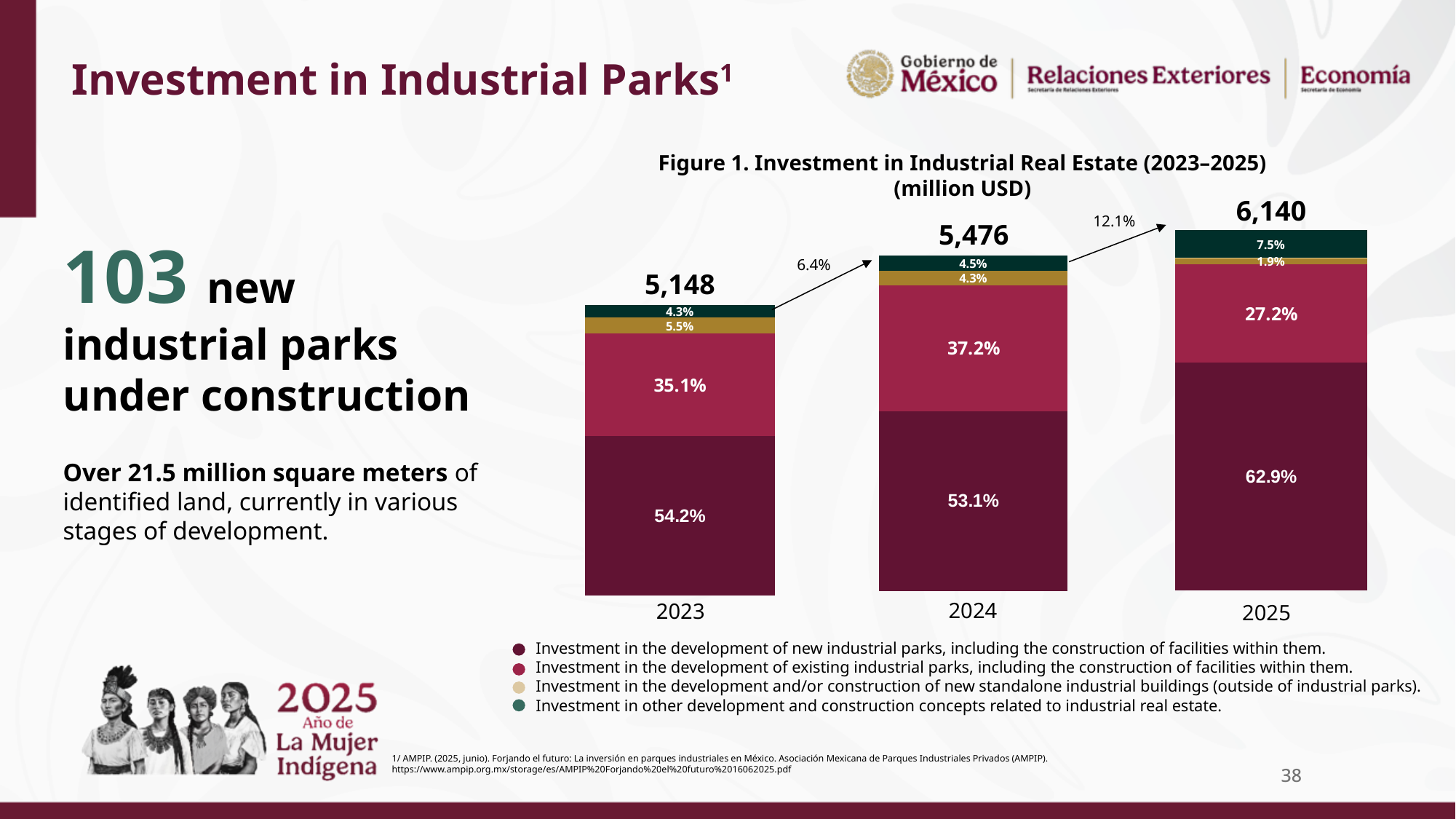
Which year has the lowest total investment in industrial real estate? 2023 What is the total investment in industrial real estate shown for 2024? 5,476 What share of the 2023 bar is investment in the development of new industrial parks? 54.2% Which year has the highest total investment in industrial real estate? 2025 What is the total investment in industrial real estate shown for 2025? 6,140 What growth percentage is shown on the arrow between the 2024 and 2025 bars? 12.1% How many series does the legend list? 4 How many years are shown on the x axis of the chart? 3 What share of the 2025 bar is investment in the development of existing industrial parks? 27.2% What is the difference between the total investment in 2025 and in 2023? 992 What percentage of the 2024 bar is investment in other development and construction concepts related to industrial real estate? 4.5% What kind of chart is Figure 1? Stacked bar chart